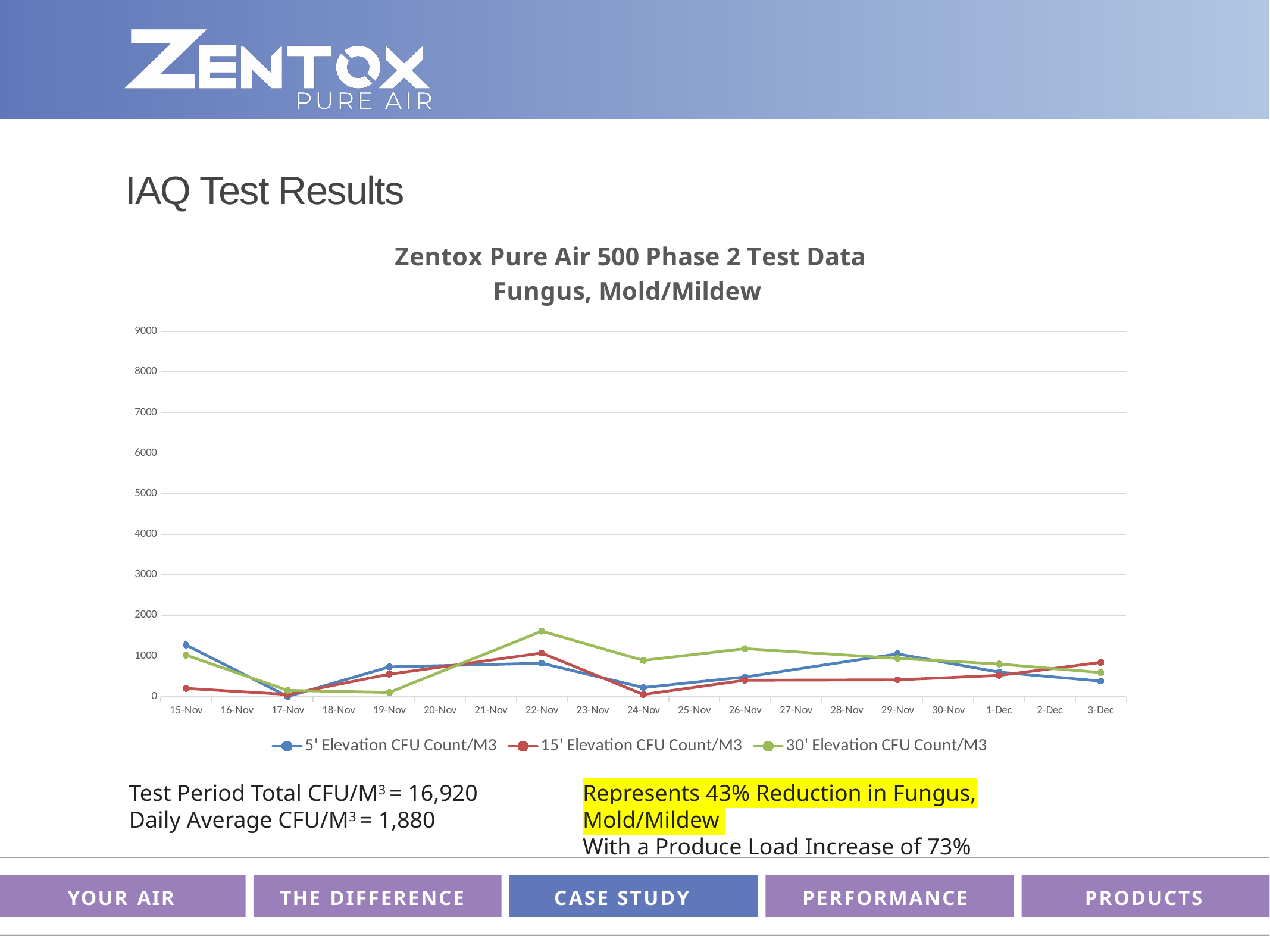
Which series is drawn in green? 30' Elevation CFU Count/M3 Is the value for 5' Elevation CFU Count/M3 on 17-Nov greater or less than 1000? less What is the title of the chart? Zentox Pure Air 500 Phase 2 Test Data Fungus, Mold/Mildew How many dates are plotted along the x axis? 19 On 22-Nov, which is larger: the 30' Elevation CFU Count/M3 value or the 15' Elevation CFU Count/M3 value? 30' Elevation CFU Count/M3 On which date does the 30' Elevation CFU Count/M3 series reach its highest value? 22-Nov On 15-Nov, which is larger: the 5' Elevation CFU Count/M3 value or the 15' Elevation CFU Count/M3 value? 5' Elevation CFU Count/M3 Is the value for 30' Elevation CFU Count/M3 on 22-Nov greater or less than 1000? greater How many series does the legend list? 3 Is the value for 15' Elevation CFU Count/M3 on 24-Nov greater or less than 1000? less On which date does the 5' Elevation CFU Count/M3 series reach its highest value? 15-Nov What kind of chart is shown on the slide? line chart